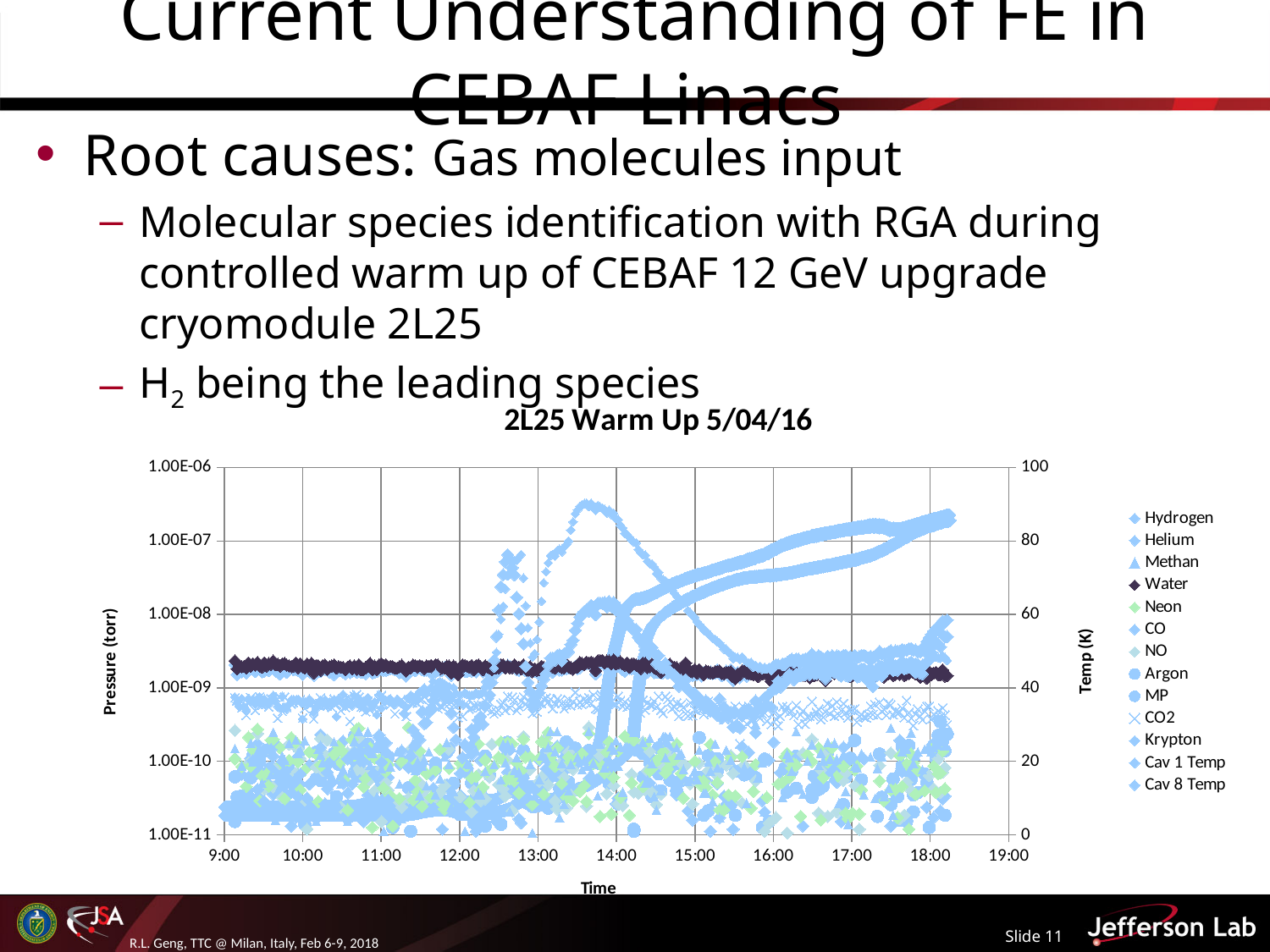
How many series does the chart legend list? 13 What is the first time shown on the x axis of the chart? 9:00 What is the last time shown on the x axis of the chart? 19:00 What kind of chart is shown on the slide? scatter chart What is the maximum value shown on the right vertical axis (Temp (K)) of the chart? 100 What is the label of the left vertical axis of the chart? Pressure (torr) Is the pressure value for the Water series at 10:00 greater or less than 1.00E-08? less Is the pressure value for the Water series at 10:00 greater or less than 1.00E-09? greater What is the title of the chart on the slide? 2L25 Warm Up 5/04/16 What is the lowest value shown on the left vertical axis of the chart? 1.00E-11 What is the highest value shown on the left vertical axis of the chart? 1.00E-06